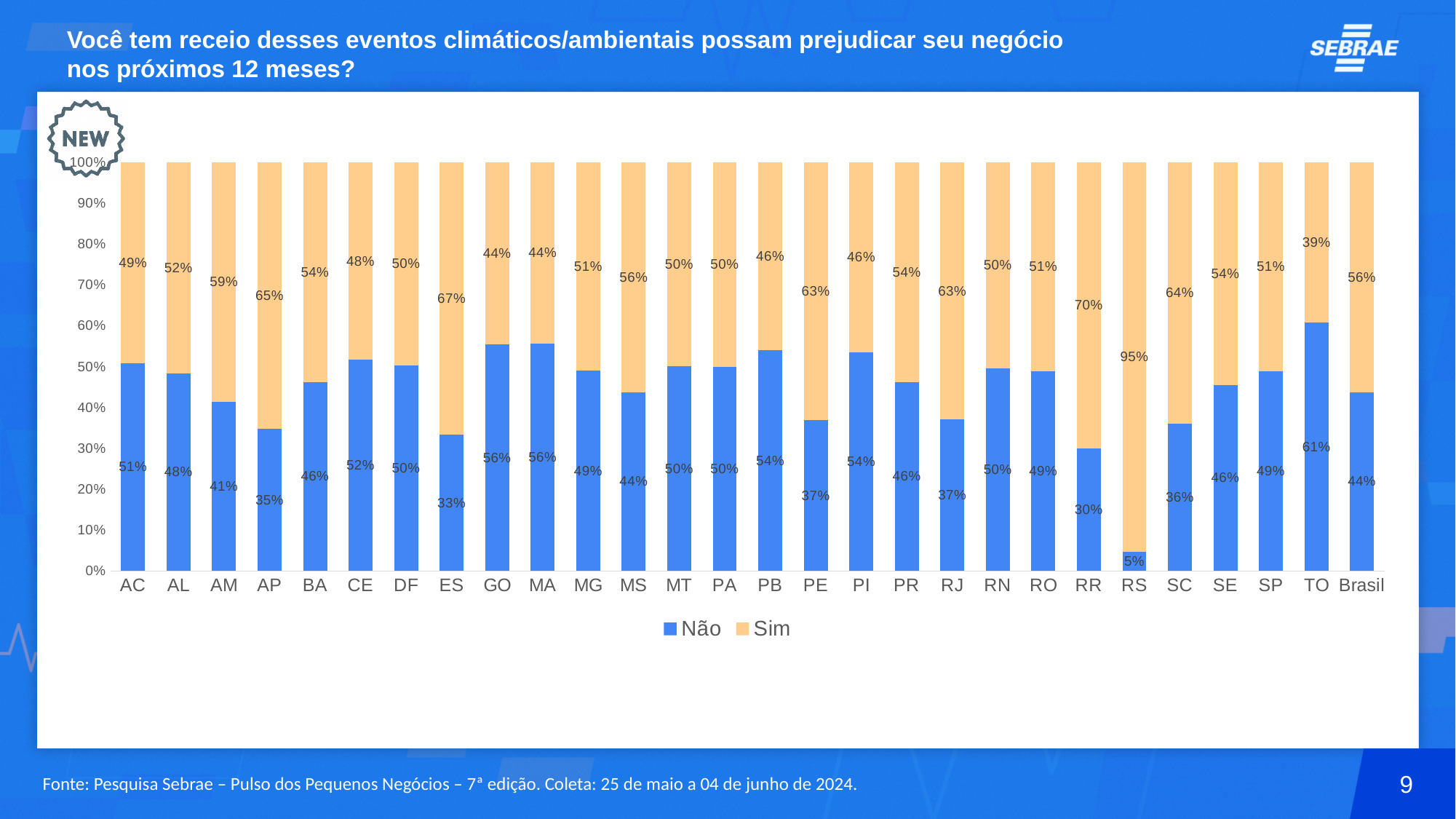
How many series does the legend list? 2 What is the "Sim" value for ES? 67% Which category has the lowest "Não" value? RS Which series is shown in blue in the legend? Não What kind of chart is shown on the slide? Stacked bar chart How many categories are shown on the x axis? 28 Which category has the lowest "Sim" value? TO Which has a larger "Não" value, TO or AP? TO What percentage of respondents in RS answered "Sim"? 95% What is the "Não" value for Brasil? 44% What is the difference between the "Sim" value for RR and the "Sim" value for Brasil? 14% Which category has the highest "Sim" value? RS